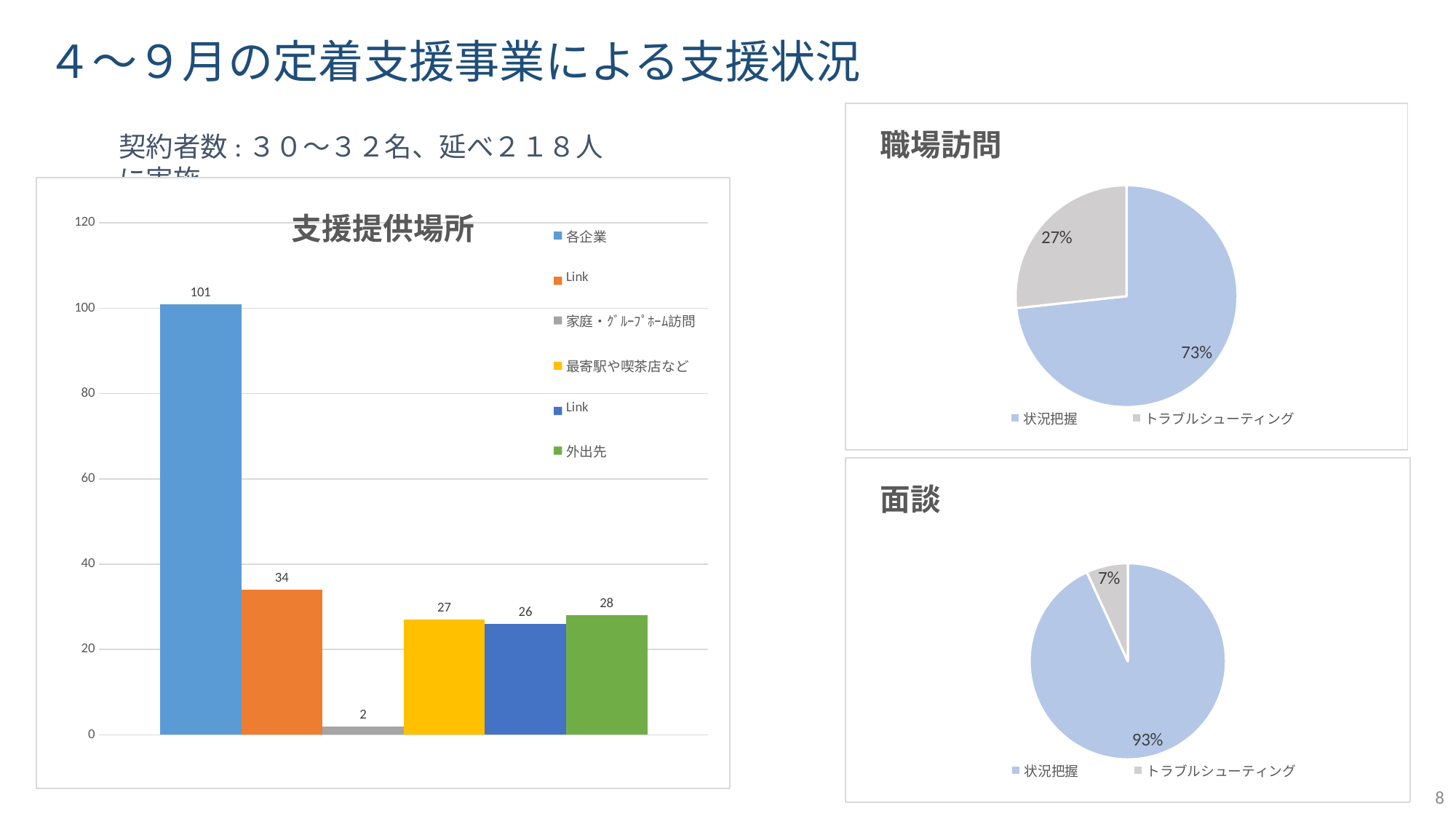
In the 支援提供場所 chart, which category has the highest value? 各企業 In the 支援提供場所 chart, what is the value for 各企業? 101 In the 面談 pie chart, what share does 状況把握 have? 93% What kind of chart is the 支援提供場所 chart? Bar chart In the 支援提供場所 chart, what is the difference between the values for 各企業 and 外出先? 73 In the 職場訪問 pie chart, what share does トラブルシューティング have? 27% In the 支援提供場所 chart, which category has the lowest value? 家庭・グループホーム訪問 In the 支援提供場所 chart, which is larger, the value for 最寄駅や喫茶店など or the value for 外出先? 外出先 In the 支援提供場所 chart, what is the value for 家庭・グループホーム訪問? 2 How many entries does the legend of the 面談 pie chart list? 2 In the 支援提供場所 chart, what is the value for 外出先? 28 In the 支援提供場所 chart, how many bars are plotted? 6